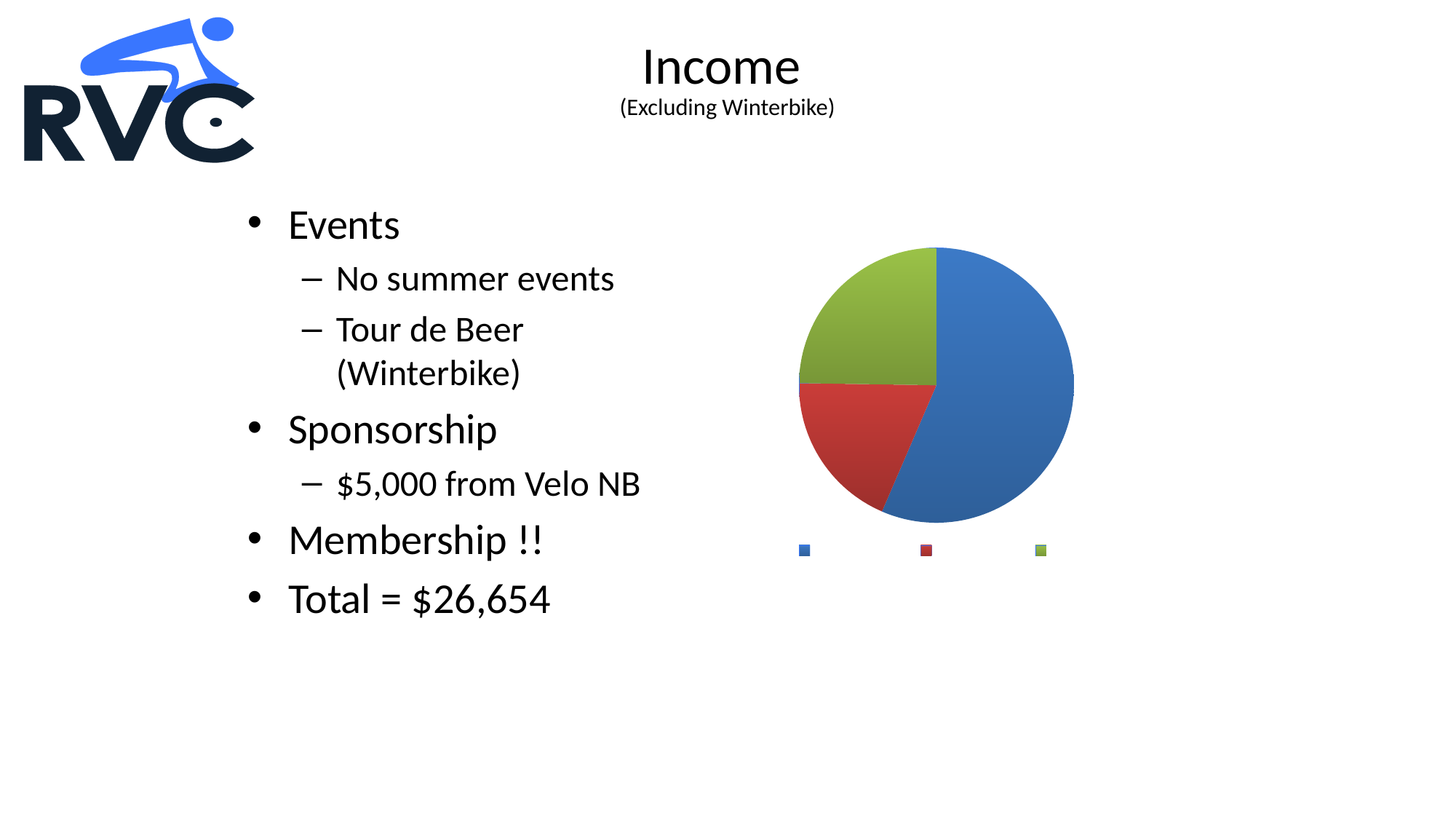
Which is larger in the pie chart, the blue slice or the green slice? blue Which colour slice is the largest in the pie chart? blue Which is larger in the pie chart, the green slice or the red slice? green How many entries does the legend below the pie chart show? 3 What colours are the three slices of the pie chart? blue, red and green Is the blue slice's share of the pie greater or less than half? greater Where is the legend positioned relative to the pie chart? below it How many slices does the pie chart have? 3 What kind of chart is shown on the slide? pie chart Which colour slice is the smallest in the pie chart? red